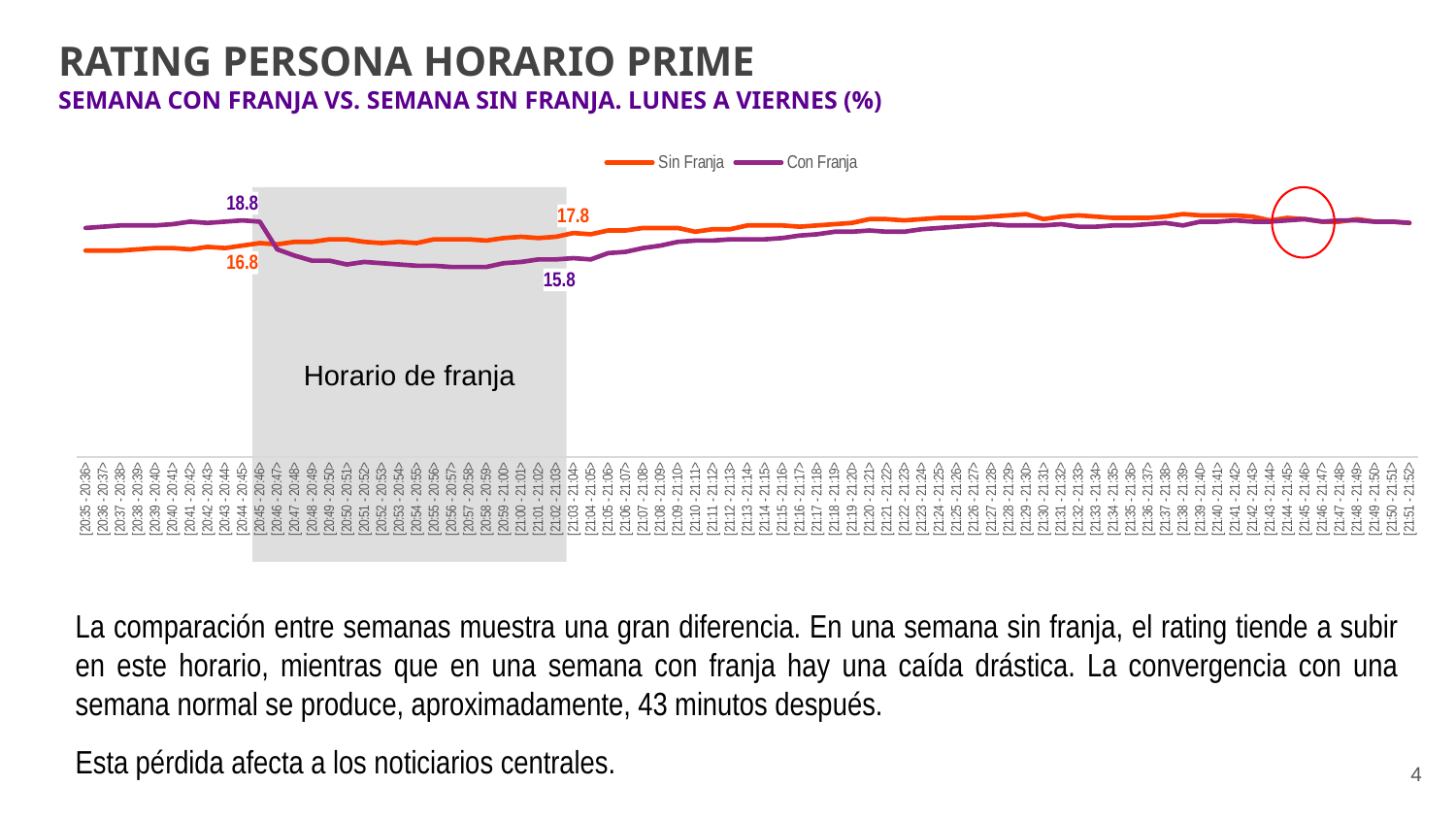
At the start of the shaded 'Horario de franja' region, which series has the higher labelled value, Sin Franja or Con Franja? Con Franja What is the labelled value of the Con Franja series at the end of the shaded 'Horario de franja' region? 15.8 What kind of chart is shown on the slide? line chart What is the difference between the Con Franja value (18.8) and the Sin Franja value (16.8) at the start of the shaded region? 2.0 How many series does the legend list? 2 What is the labelled value of the Con Franja series at the start of the shaded 'Horario de franja' region? 18.8 Does the Con Franja series rise or fall when it enters the shaded 'Horario de franja' region? fall What is the difference between the Sin Franja value (17.8) and the Con Franja value (15.8) at the end of the shaded region? 2.0 What label is written inside the shaded region of the chart? Horario de franja What is the labelled value of the Sin Franja series at the start of the shaded 'Horario de franja' region? 16.8 What are the two series named in the legend? Sin Franja and Con Franja What is the labelled value of the Sin Franja series at the end of the shaded 'Horario de franja' region? 17.8